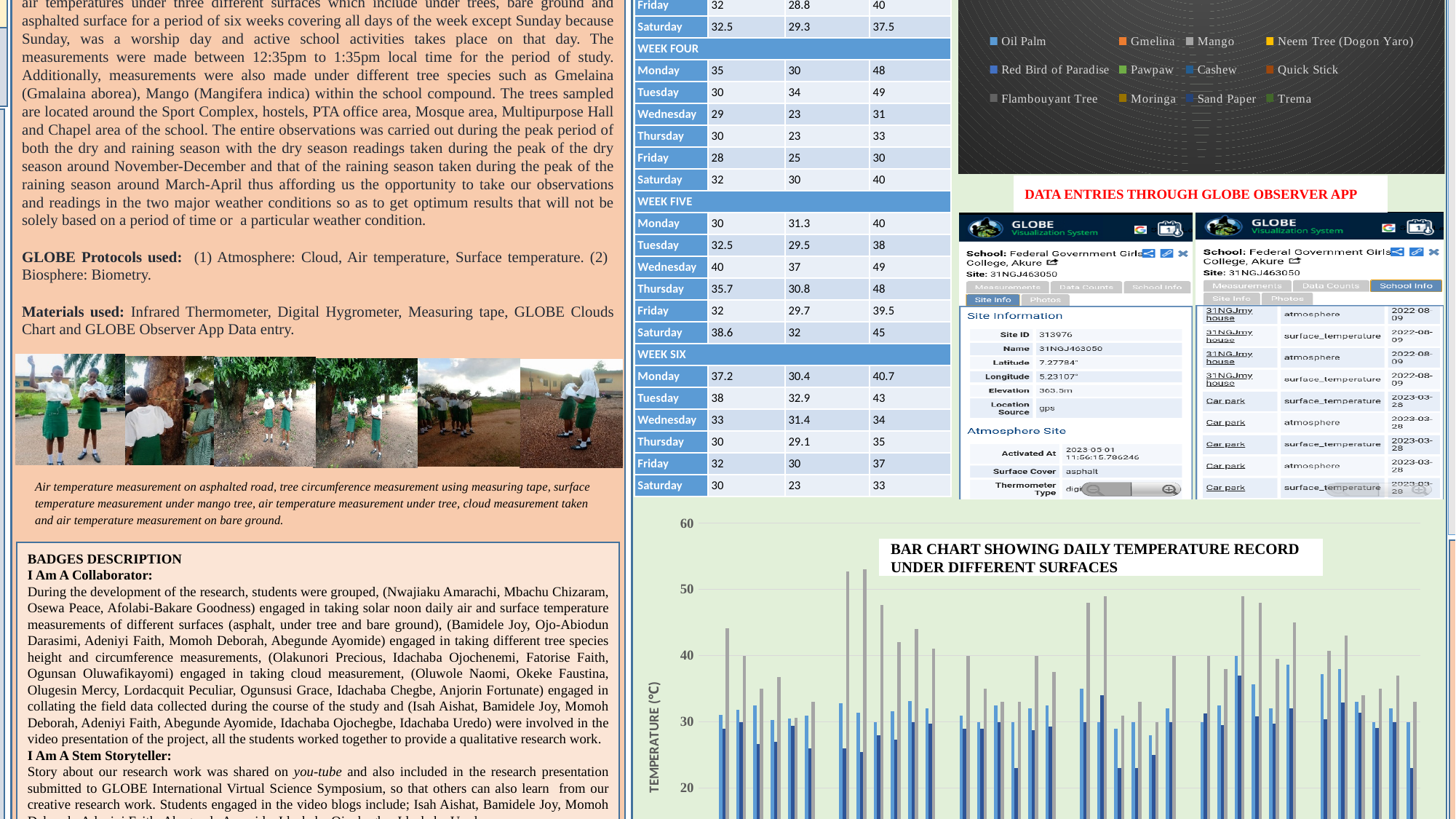
In the bar chart at the bottom right, is the tallest bar greater or less than 50? greater What kind of chart is the chart titled 'BAR CHART SHOWING DAILY TEMPERATURE RECORD UNDER DIFFERENT SURFACES'? bar chart In the bar chart at the bottom right, what is the highest tick value shown on the vertical axis? 60 In the bar chart at the bottom right, is the tallest bar greater or less than 60? less How many entries does the legend of the chart at the top right of the slide list? 12 In the bar chart at the bottom right, what is the label on the vertical axis? TEMPERATURE (°C) In the legend of the chart at the top right of the slide, which entry is listed first? Oil Palm